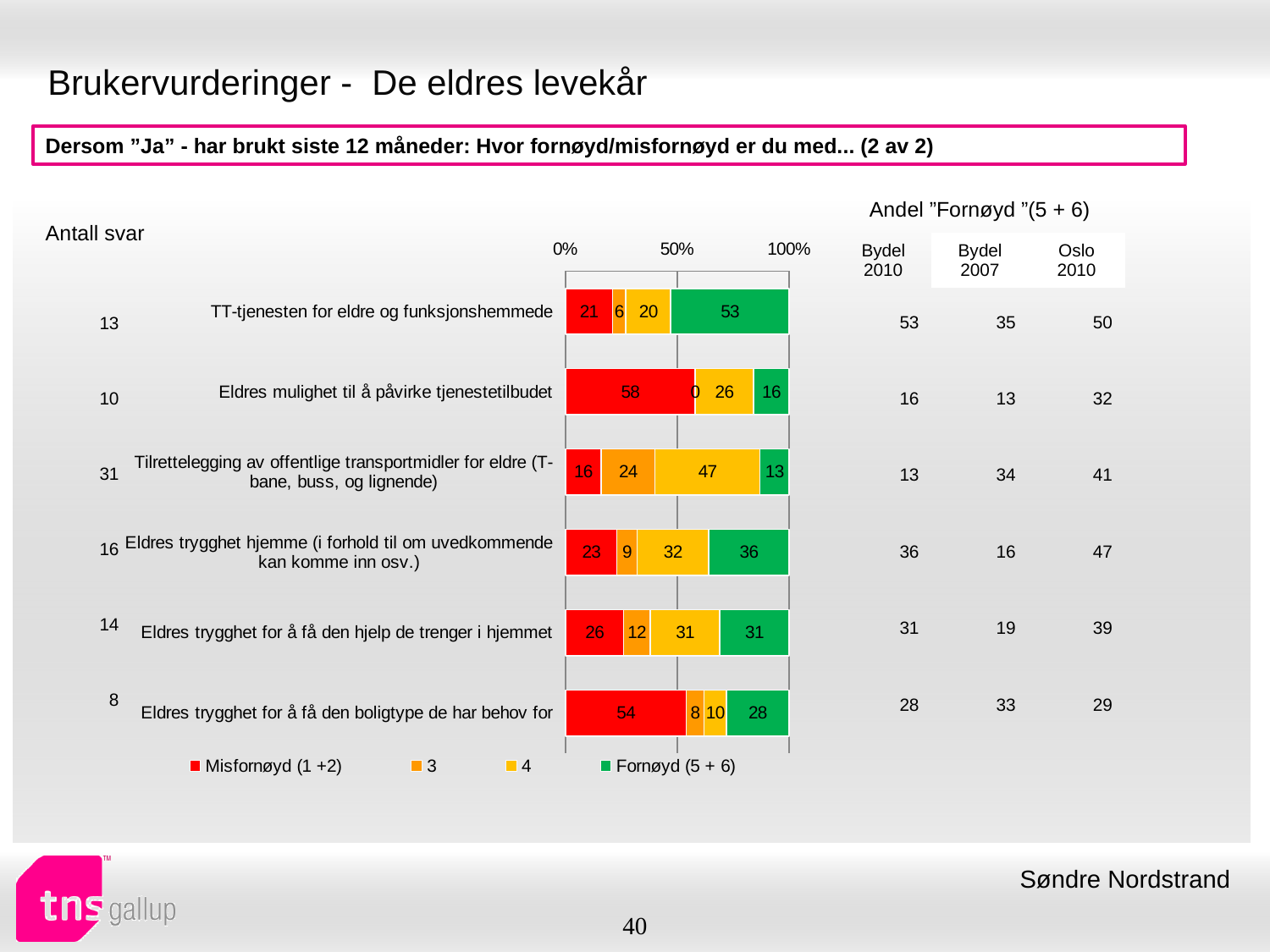
How many series does the legend list? 4 How many categories are shown in the bar chart? 6 What is the value of the Fornøyd (5 + 6) segment for "TT-tjenesten for eldre og funksjonshemmede"? 53 Which category has the highest Misfornøyd (1 +2) value? Eldres mulighet til å påvirke tjenestetilbudet Which has a larger Fornøyd (5 + 6) value: "Eldres trygghet hjemme (i forhold til om uvedkommende kan komme inn osv.)" or "Eldres trygghet for å få den boligtype de har behov for"? Eldres trygghet hjemme (i forhold til om uvedkommende kan komme inn osv.) What is the value of the "4" segment for "Tilrettelegging av offentlige transportmidler for eldre (T-bane, buss, og lignende)"? 47 Which category has the lowest Fornøyd (5 + 6) value? Tilrettelegging av offentlige transportmidler for eldre (T-bane, buss, og lignende) What is the value of the Misfornøyd (1 +2) segment for "Eldres mulighet til å påvirke tjenestetilbudet"? 58 Which category has the highest Fornøyd (5 + 6) value? TT-tjenesten for eldre og funksjonshemmede What kind of chart is shown on the slide? Stacked bar chart What is the difference between the Misfornøyd (1 +2) values for "Eldres trygghet for å få den boligtype de har behov for" and "TT-tjenesten for eldre og funksjonshemmede"? 33 What is the total of the stacked bar for "TT-tjenesten for eldre og funksjonshemmede"? 100